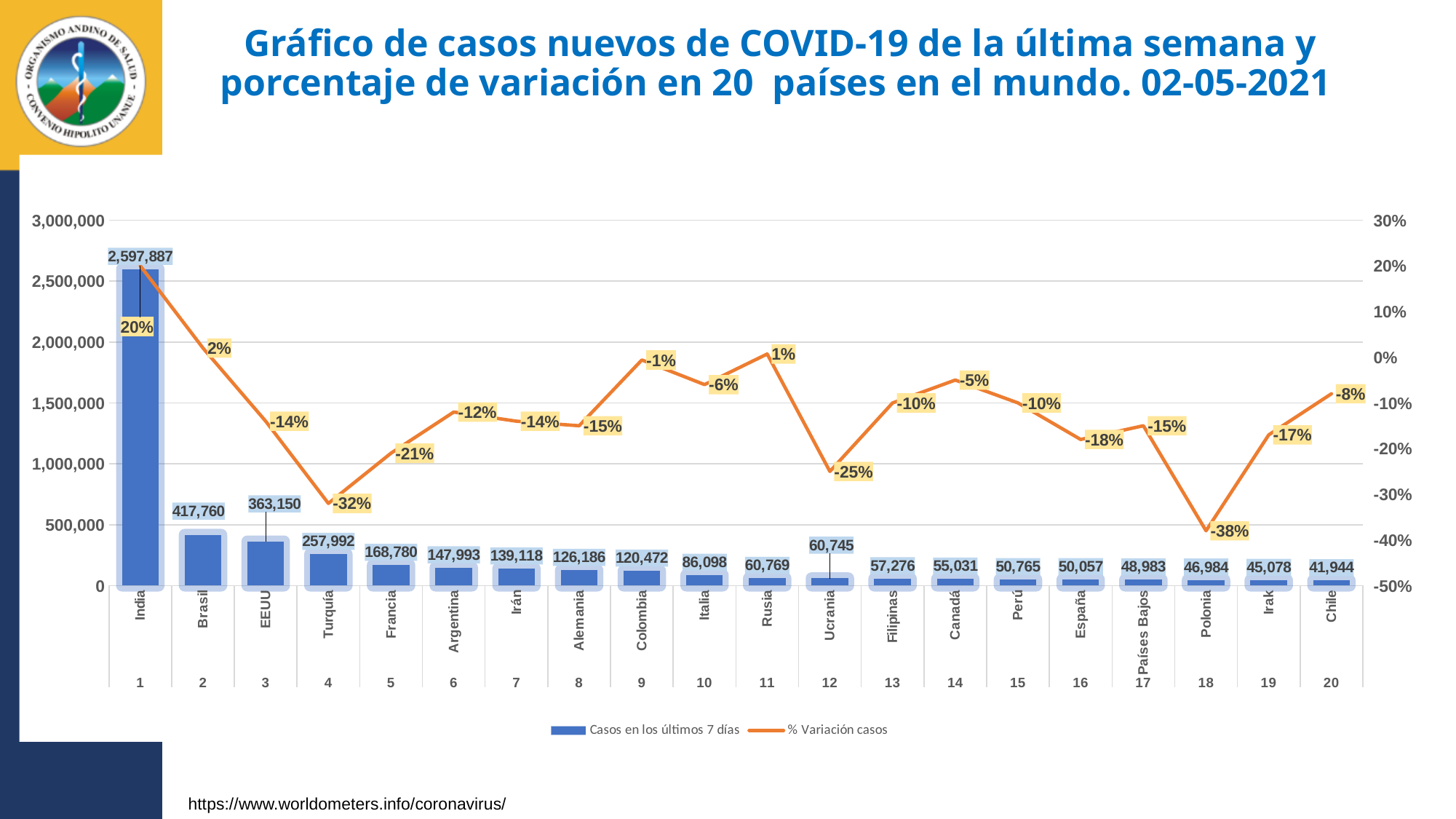
Which country has the highest number of cases in the last 7 days? India What is the percentage variation in cases shown for Turquía? -32% How many new cases in the last 7 days are shown for Brasil? 417,760 What is the difference in cases in the last 7 days between Brasil and EEUU? 54,610 Which has more cases in the last 7 days, Francia or Argentina? Francia Do the values for cases in the last 7 days rise or fall from India to Chile along the x axis? fall Which country has the lowest percentage variation in cases? Polonia How many series does the legend list? 2 How many countries are shown on the chart? 20 What is the number of cases in the last 7 days for Chile? 41,944 What kind of chart is used for the 'Casos en los últimos 7 días' series? bar chart Is the value for cases in the last 7 days for Turquía greater or less than 500,000? less